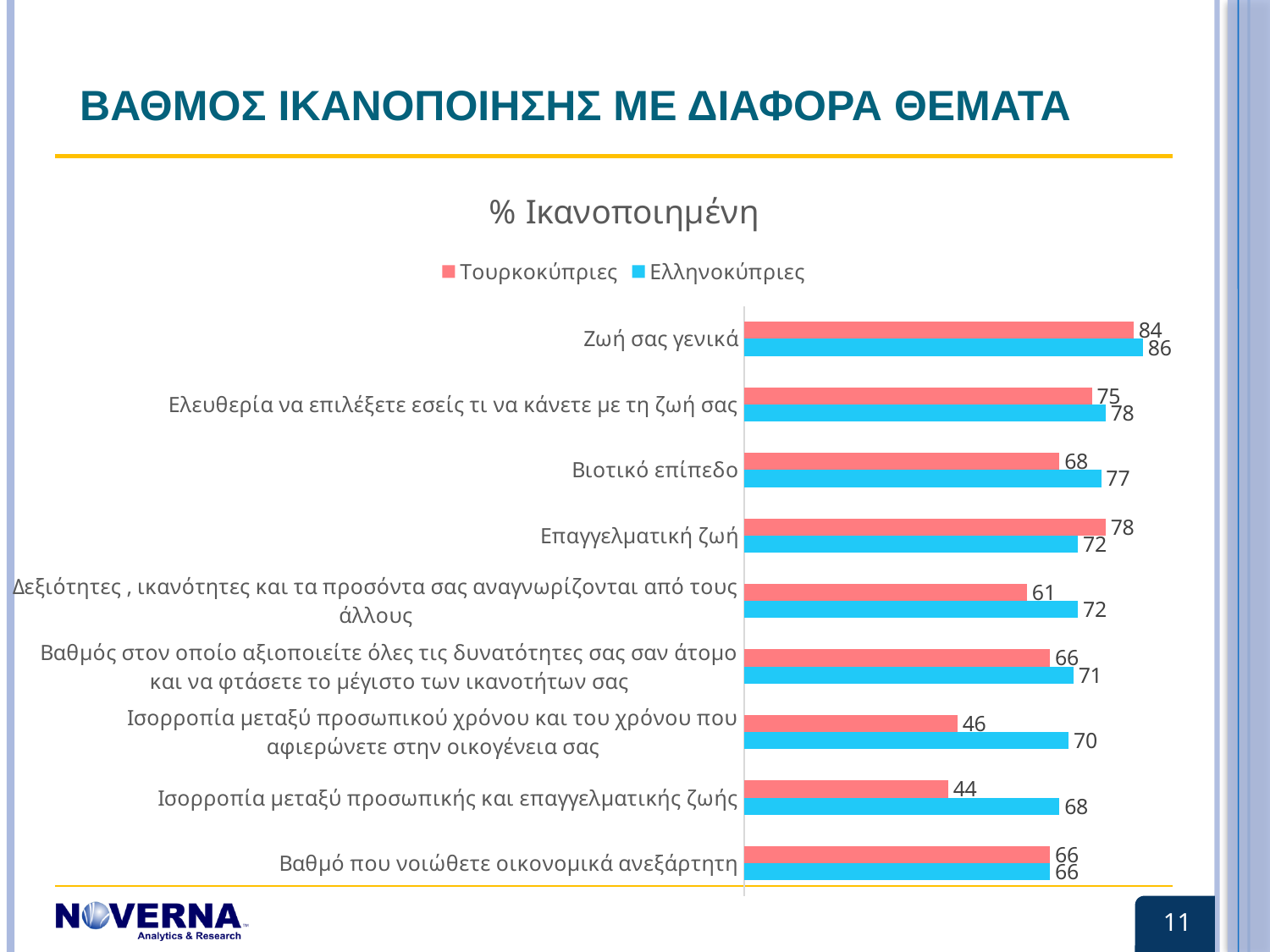
What is the title of the chart? % Ικανοποιημένη For 'Επαγγελματική ζωή', which series has the larger value, Τουρκοκύπριες or Ελληνοκύπριες? Τουρκοκύπριες What is the difference between the Ελληνοκύπριες and Τουρκοκύπριες values for 'Δεξιότητες, ικανότητες και τα προσόντα σας αναγνωρίζονται από τους άλλους'? 11 How many series does the legend list? 2 Which category has the lowest value for Τουρκοκύπριες? Ισορροπία μεταξύ προσωπικής και επαγγελματικής ζωής What is the value for Τουρκοκύπριες for 'Ισορροπία μεταξύ προσωπικής και επαγγελματικής ζωής'? 44 Which category has the highest value for Ελληνοκύπριες? Ζωή σας γενικά What is the difference between the Ελληνοκύπριες and Τουρκοκύπριες values for 'Ισορροπία μεταξύ προσωπικού χρόνου και του χρόνου που αφιερώνετε στην οικογένεια σας'? 24 What is the value for Ελληνοκύπριες for 'Βιοτικό επίπεδο'? 77 What is the value for Τουρκοκύπριες for 'Ζωή σας γενικά'? 84 How many categories are shown in the chart? 9 What type of chart is shown on the slide? bar chart